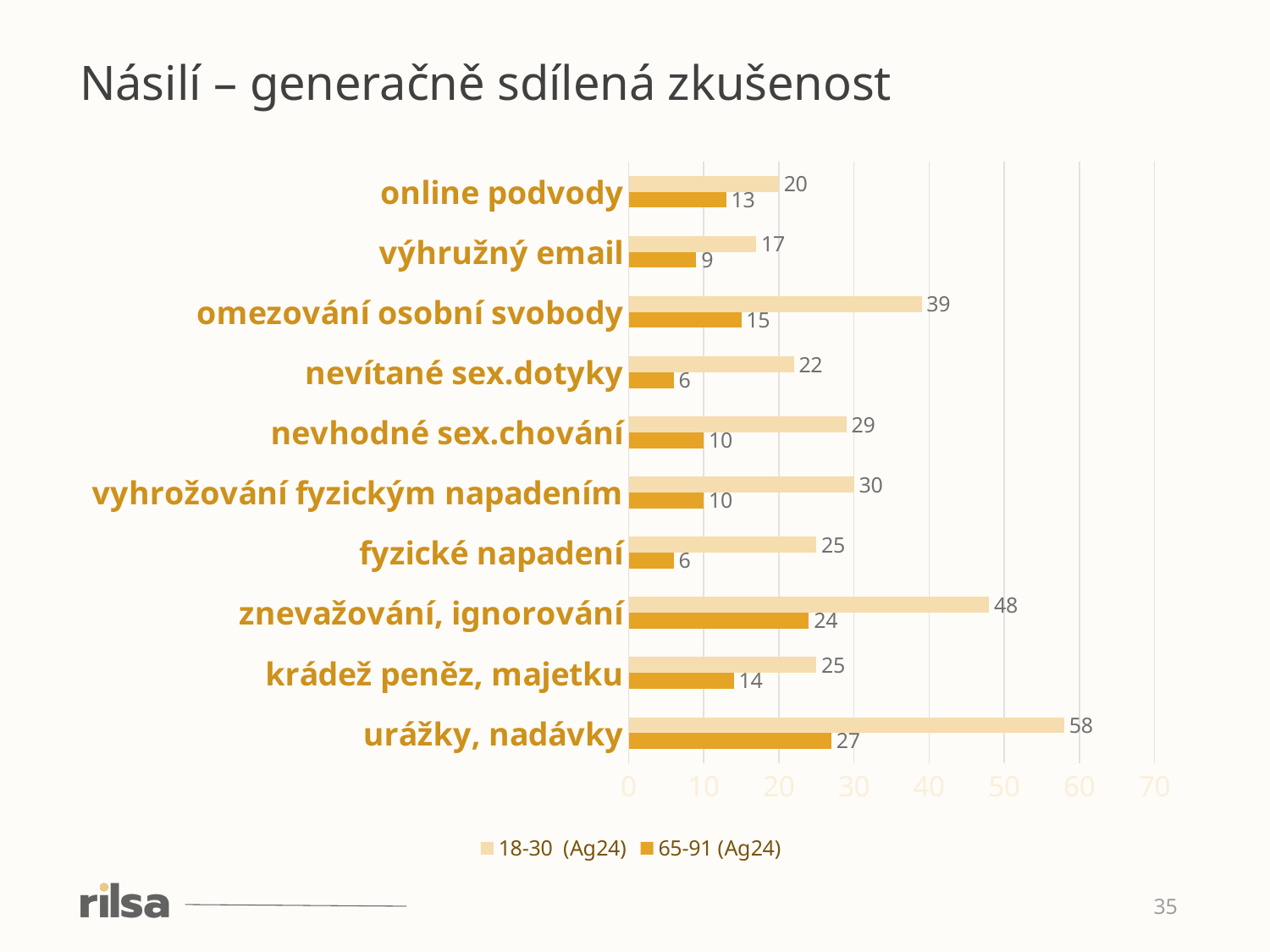
What is the difference between the 18-30 (Ag24) and 65-91 (Ag24) values for "znevažování, ignorování"? 24 Is the 18-30 (Ag24) value for "omezování osobní svobody" greater or less than 30? greater What is the title of the slide? Násilí – generačně sdílená zkušenost Which is larger for "nevítané sex.dotyky": the 18-30 (Ag24) value or the 65-91 (Ag24) value? 18-30 (Ag24) Which category has the lowest value in the 18-30 (Ag24) series? výhružný email How many categories are shown on the chart? 10 What is the value for "omezování osobní svobody" in the 65-91 (Ag24) series? 15 What is the value for "urážky, nadávky" in the 18-30 (Ag24) series? 58 Which category has the highest value in the 18-30 (Ag24) series? urážky, nadávky What is the value for "online podvody" in the 65-91 (Ag24) series? 13 How many series does the legend list? 2 What kind of chart is shown on the slide? bar chart